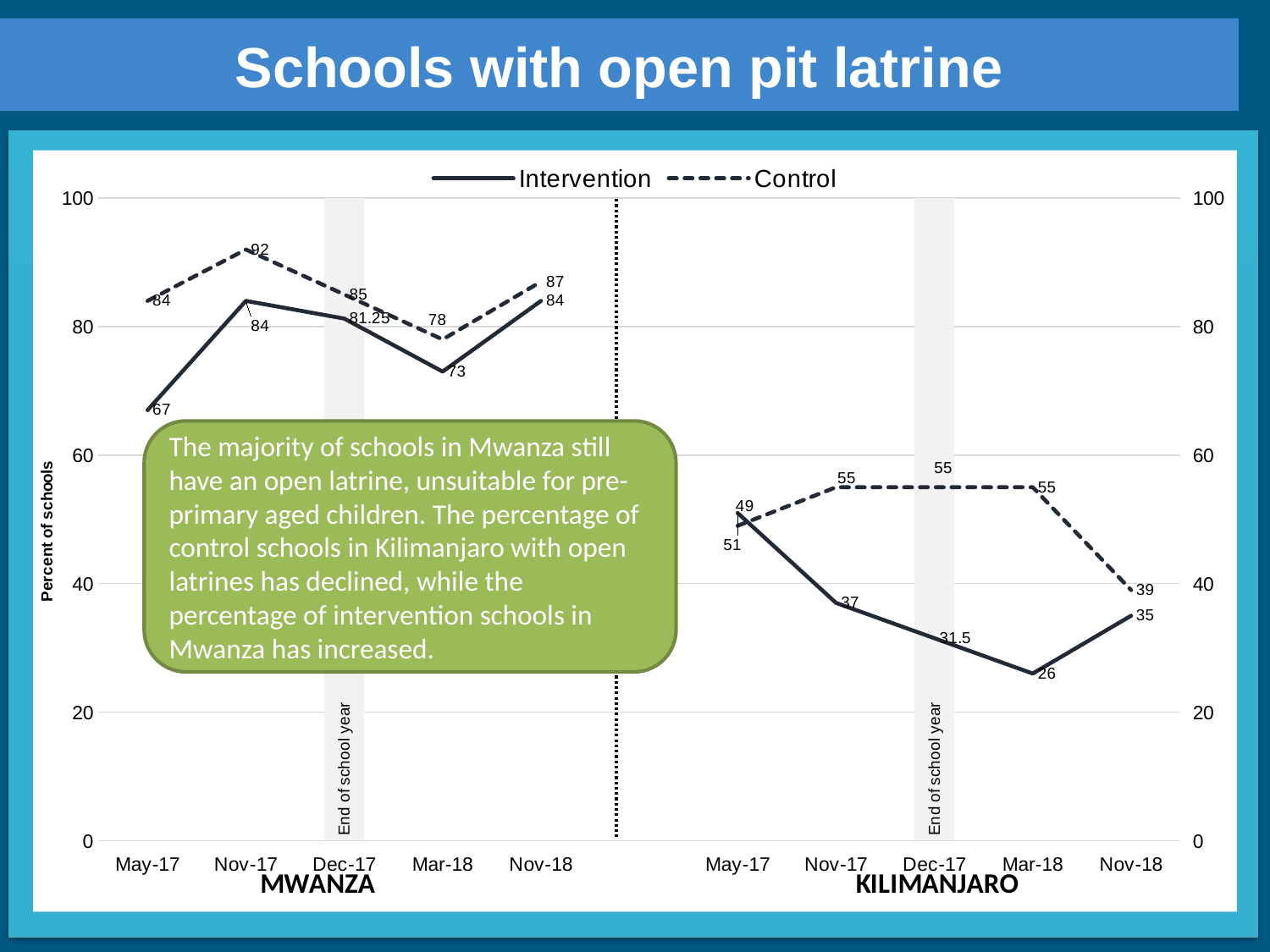
In the Kilimanjaro panel, which is larger at Nov-17: the Control value or the Intervention value? Control In the Kilimanjaro panel, what is the Intervention value at Dec-17? 31.5 How many series does the legend list? 2 In the Mwanza panel, what is the Control value at Nov-17? 92 In the Mwanza panel, at which time point is the Intervention value lowest? May-17 In the Kilimanjaro panel, what is the Control value at Nov-18? 39 In the Mwanza panel, what is the difference between the Control and Intervention values at Mar-18? 5 In the Mwanza panel, what is the Intervention value at May-17? 67 What is the title of the chart? Schools with open pit latrine In the Kilimanjaro panel, at which time point is the Intervention value lowest? Mar-18 What type of chart is shown on the slide? Line chart How many time points are shown on the x axis of the Mwanza panel? 5